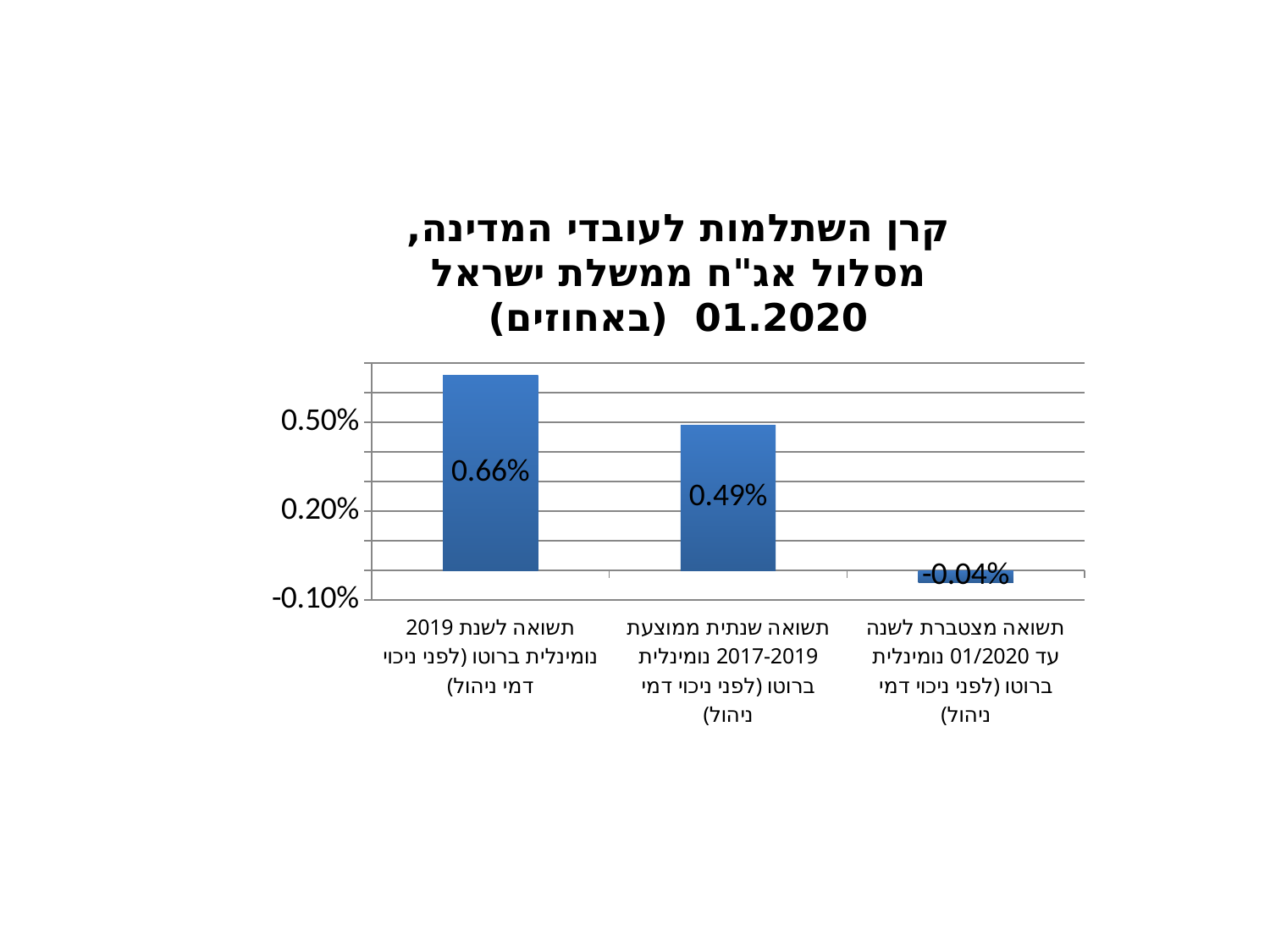
Which is larger: the 2019 annual return or the 2017-2019 average annual return? the 2019 annual return (0.66%) What is the value for the category 'תשואה שנתית ממוצעת 2017-2019 נומינלית ברוטו (לפני ניכוי דמי ניהול)'? 0.49% What is the value for the category 'תשואה לשנת 2019 נומינלית ברוטו (לפני ניכוי דמי ניהול)'? 0.66% What type of chart is shown on the slide? bar chart Which category has the highest value? תשואה לשנת 2019 נומינלית ברוטו (לפני ניכוי דמי ניהול) Is the value for the 2017-2019 average annual return greater or less than 0.50%? less What is the difference between the 2019 annual return (0.66%) and the 2017-2019 average annual return (0.49%)? 0.17% How many bars (categories) are plotted in the chart? 3 What is the value for the category 'תשואה מצטברת לשנה עד 01/2020 נומינלית ברוטו (לפני ניכוי דמי ניהול)'? -0.04% Which category has the lowest value? תשואה מצטברת לשנה עד 01/2020 נומינלית ברוטו (לפני ניכוי דמי ניהול) What is the title of the chart? קרן השתלמות לעובדי המדינה, מסלול אג"ח ממשלת ישראל 01.2020 (באחוזים) Is the value for the cumulative return for the year to 01/2020 positive or negative? negative